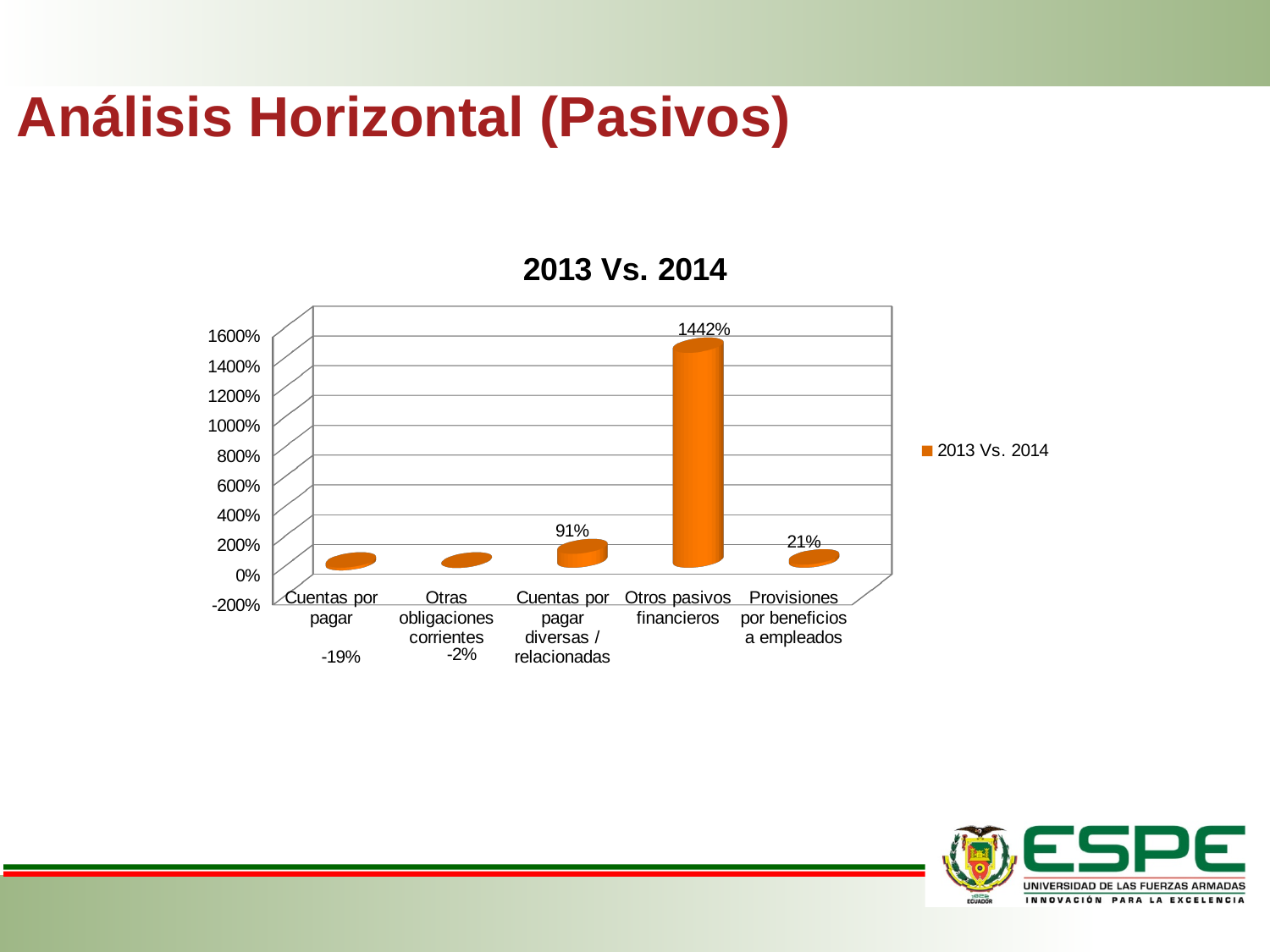
Which category has the highest value? Otros pasivos financieros How many series does the legend list? 1 Which is larger, the value for Cuentas por pagar diversas / relacionadas or the value for Provisiones por beneficios a empleados? Cuentas por pagar diversas / relacionadas How many categories are shown on the x axis? 5 Which category has the lowest value? Cuentas por pagar What kind of chart is shown on the slide? Bar chart What is the value for Cuentas por pagar? -19% What is the value for Otros pasivos financieros? 1442% What is the value for Cuentas por pagar diversas / relacionadas? 91% What is the value for Provisiones por beneficios a empleados? 21% What is the value for Otras obligaciones corrientes? -2% What is the difference between the values for Otros pasivos financieros and Cuentas por pagar diversas / relacionadas? 1351%